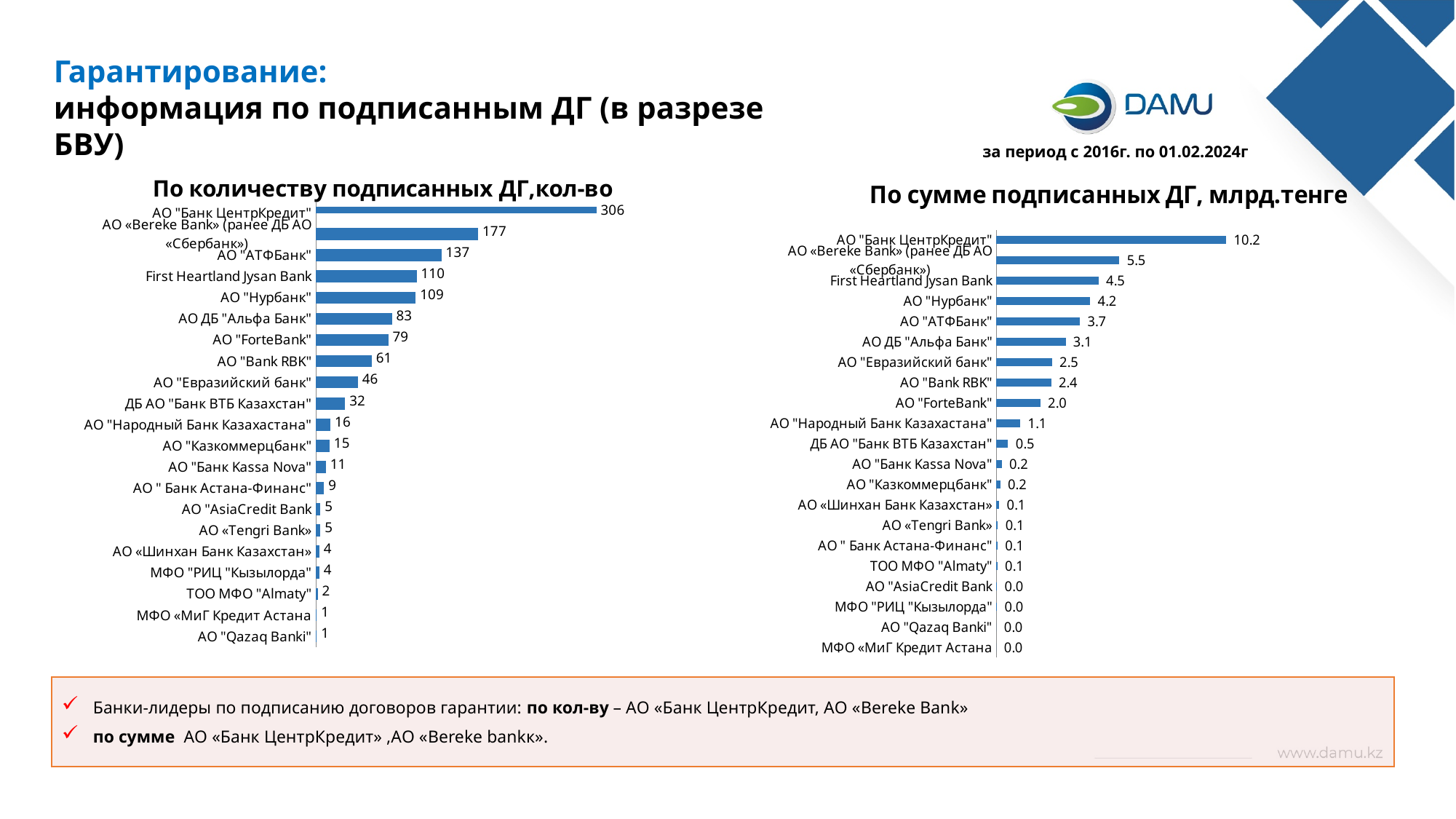
In the chart "По сумме подписанных ДГ, млрд.тенге", what is the value for АО "Евразийский банк"? 2.5 In the chart "По количеству подписанных ДГ,кол-во", what is the value for АО "Банк ЦентрКредит"? 306 In the chart "По сумме подписанных ДГ, млрд.тенге", what is the difference between АО "Нурбанк" and АО "АТФБанк"? 0.5 In the chart "По количеству подписанных ДГ,кол-во", what is the difference between АО "Банк ЦентрКредит" and АО «Bereke Bank» (ранее ДБ АО «Сбербанк»)? 129 In the chart "По сумме подписанных ДГ, млрд.тенге", which bank has the highest value? АО "Банк ЦентрКредит" In the chart "По сумме подписанных ДГ, млрд.тенге", what is the value for First Heartland Jysan Bank? 4.5 In the chart "По количеству подписанных ДГ,кол-во", which is larger: АО ДБ "Альфа Банк" or АО "ForteBank"? АО ДБ "Альфа Банк" How many categories are shown in the chart "По количеству подписанных ДГ,кол-во"? 21 In the chart "По количеству подписанных ДГ,кол-во", what is the value for АО "Нурбанк"? 109 In the chart "По сумме подписанных ДГ, млрд.тенге", which is larger: АО "Bank RBK" or АО "ForteBank"? АО "Bank RBK" What is the title of the chart on the right side of the slide? По сумме подписанных ДГ, млрд.тенге What kind of chart is "По сумме подписанных ДГ, млрд.тенге"? bar chart